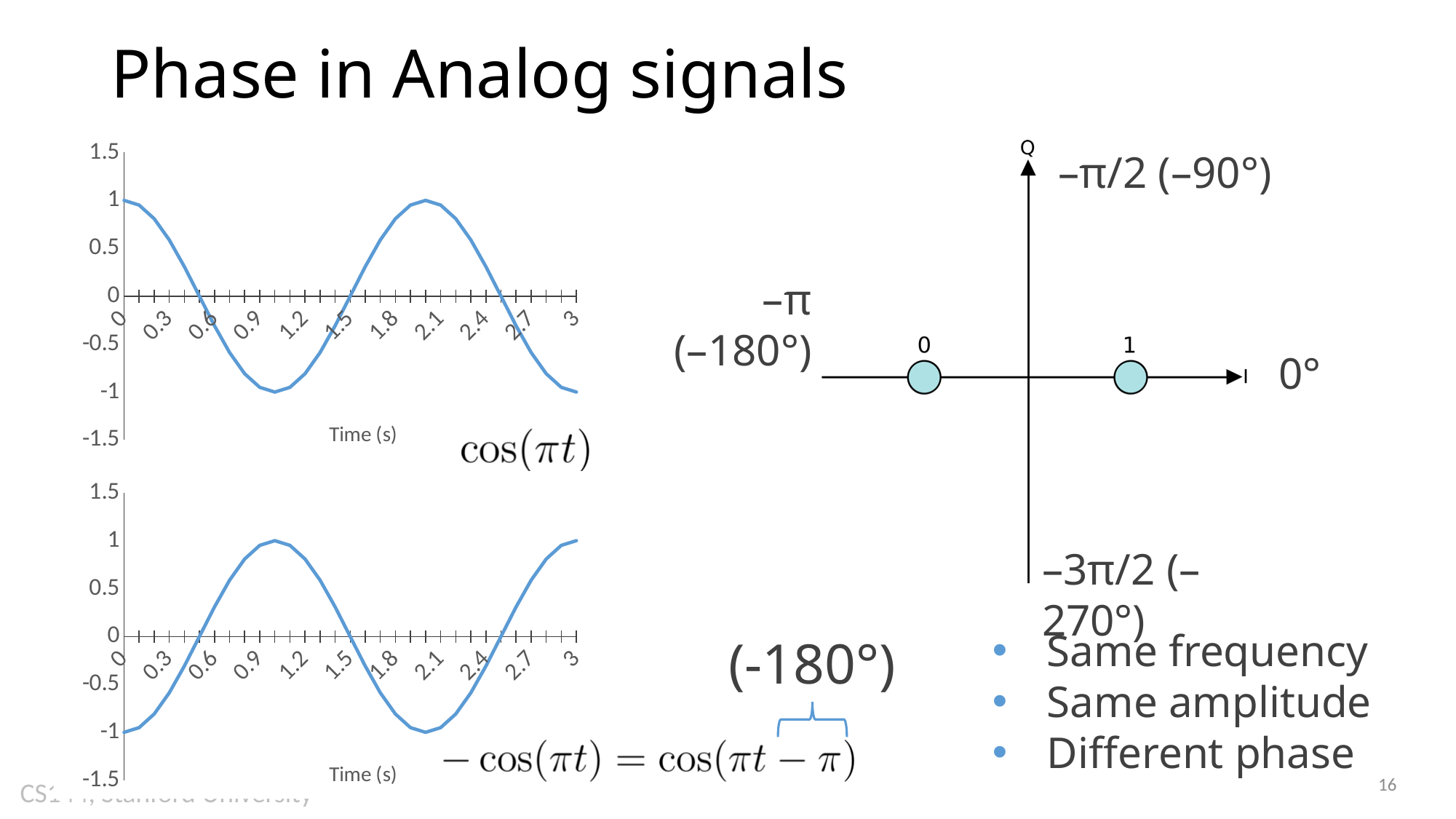
In the bottom chart (−cos(πt)), what is the value of the curve at time 3? 1 In the top chart (cos(πt)), is the value at time 0.9 greater or less than 0? less In the top chart (cos(πt)), does the curve rise or fall between time 0 and time 0.9? fall In the top chart (cos(πt)), what is the value of the curve at time 3? -1 In the bottom chart (−cos(πt)), is the value at time 0.9 greater or less than 0? greater In the top chart (cos(πt)), what is the value of the curve at time 0? 1 What is the highest tick value shown on the y-axis of the top chart? 1.5 In the bottom chart (−cos(πt)), what is the value of the curve at time 0? -1 How many lines are plotted in the bottom chart on the left? 1 What is the x-axis label of the bottom chart on the left? Time (s) What kind of chart is the top chart on the left? line chart In the bottom chart (−cos(πt)), does the curve rise or fall between time 0 and time 0.9? rise